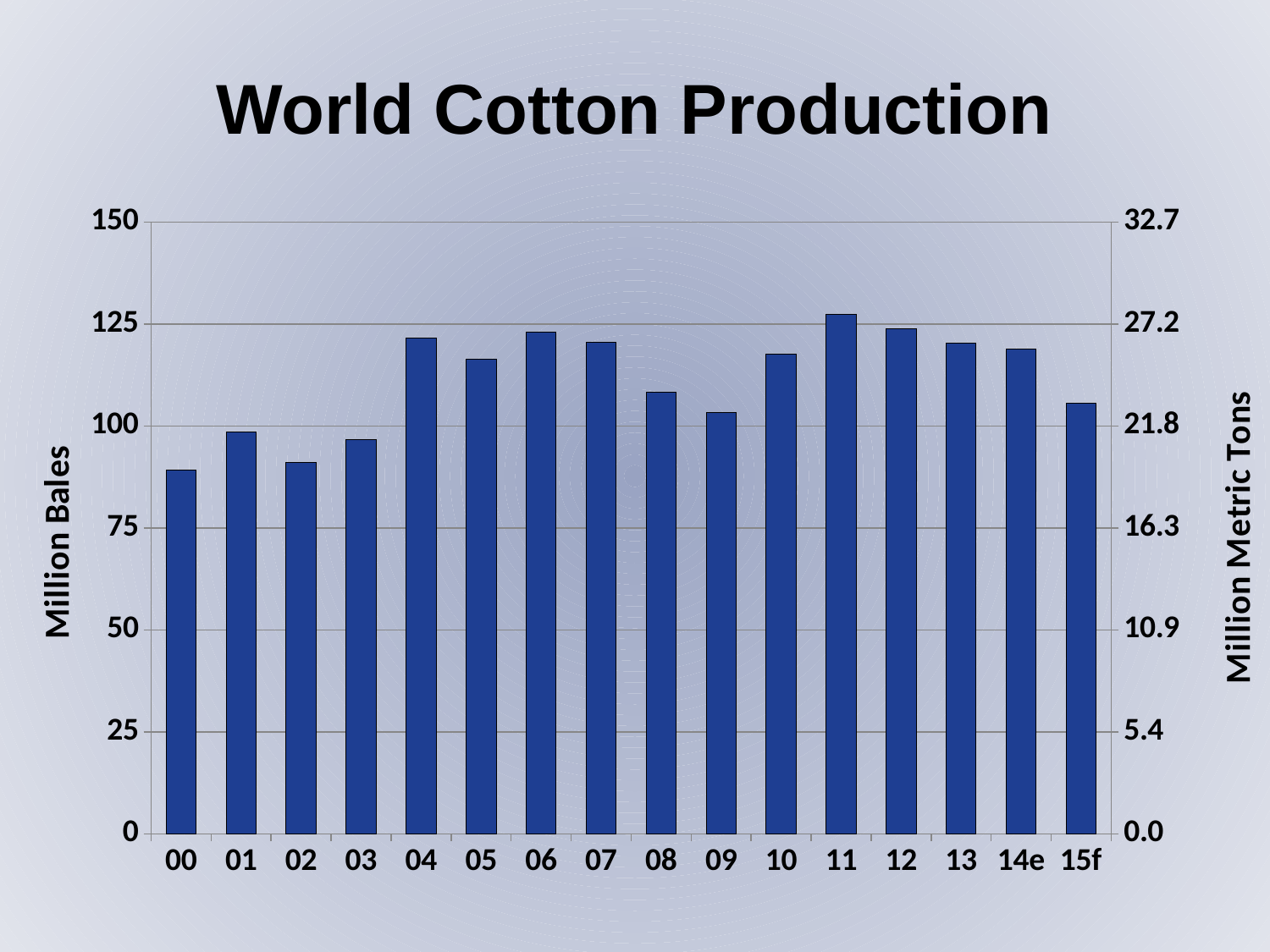
Do the values rise or fall from 11 to 15f? fall Is the value for 08 greater or less than 125 million bales? less Is the value for 11 greater or less than 125 million bales? greater Is the value for 04 greater or less than 100 million bales? greater What kind of chart is shown on the slide? bar chart Which year has the larger production, 03 or 04? 04 Which year has the larger production, 14e or 15f? 14e How many years (bars) are shown on the x axis? 16 What is the label of the left vertical axis? Million Bales Which year has the highest world cotton production? 11 What is the title of the chart? World Cotton Production